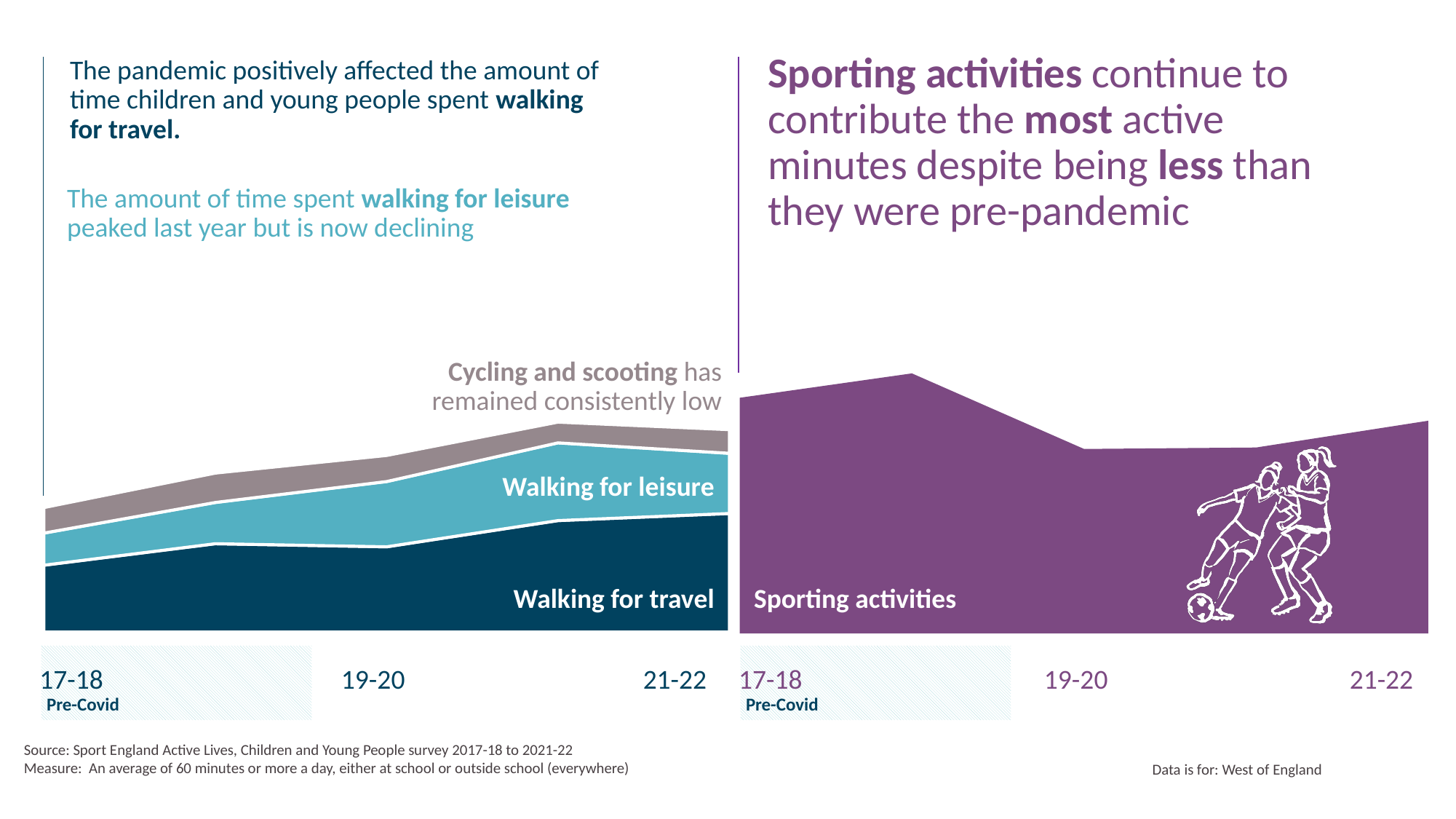
On the left chart, which three series are labelled? Walking for travel, Walking for leisure, Cycling and scooting What kind of chart is the right chart showing sporting activities? Area chart On the left chart, is the Walking for leisure band thicker in 21-22 or in 17-18? 21-22 On the right chart, does the Sporting activities area rise or fall from 17-18 to 19-20? Fall On the right chart, which year label is marked as Pre-Covid? 17-18 On the left chart, how many series are labelled? 3 What kind of chart is the left chart showing walking and cycling activities? Area chart On the left chart, which series is the bottom layer of the stacked area? Walking for travel On the left chart, how many year labels appear on the x axis? 3 On the right chart, is the Sporting activities value in 21-22 higher or lower than in 17-18? Lower On the right chart, how many series are shown? 1 On the left chart, does the Walking for travel area rise or fall overall from 17-18 to 21-22? Rise